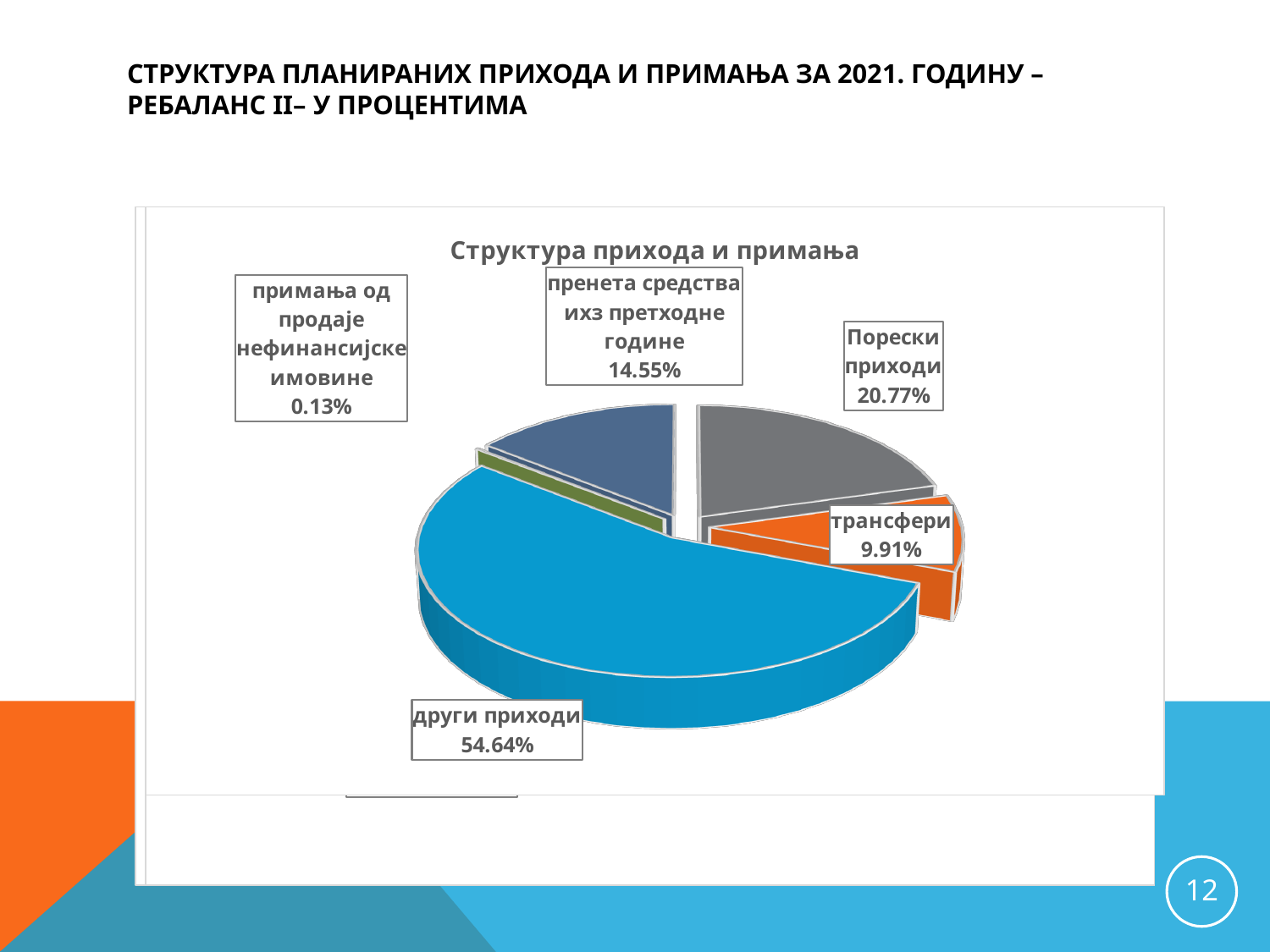
What is the value shown for "Порески приходи"? 20.77% What is the value shown for "пренета средства ихз претходне године"? 14.55% What is the value shown for "трансфери"? 9.91% Which is larger, "Порески приходи" or "трансфери"? Порески приходи Which category has the smallest share of the pie? примања од продаје нефинансијске имовине What is the difference between the shares of "Порески приходи" and "пренета средства ихз претходне године"? 6.22% What share does "други приходи" have in the pie chart? 54.64% What kind of chart is shown on the slide? Pie chart What is the title of the chart? Структура прихода и примања How many slices does the pie chart have? 5 Which category has the largest share of the pie? други приходи What is the value shown for "примања од продаје нефинансијске имовине"? 0.13%